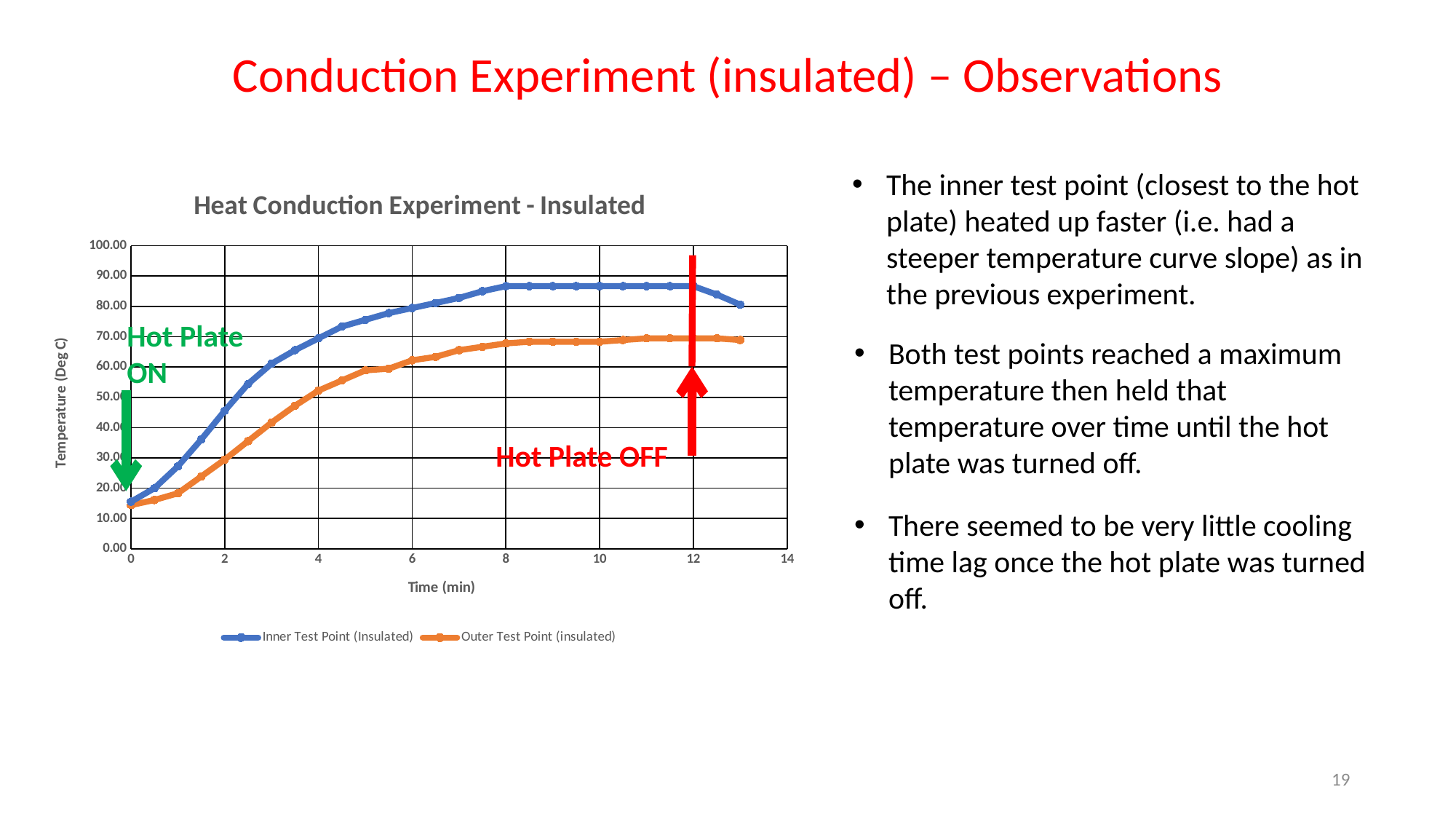
At 6 min, which series has the higher temperature, Inner Test Point (Insulated) or Outer Test Point (insulated)? Inner Test Point (Insulated) Is the value for Outer Test Point (insulated) at 8 min greater or less than 60? greater How many series does the legend list? 2 What is the label of the y axis? Temperature (Deg C) Is the value for Inner Test Point (Insulated) at 8 min greater or less than 80? greater Is the value for Inner Test Point (Insulated) at 4 min greater or less than 60? greater Does the Inner Test Point (Insulated) series rise or fall between 12 and 13 min? Fall What kind of chart is shown on the slide? Line chart What is the title of the chart? Heat Conduction Experiment - Insulated Does the Inner Test Point (Insulated) series rise or fall between 0 and 8 min? Rise